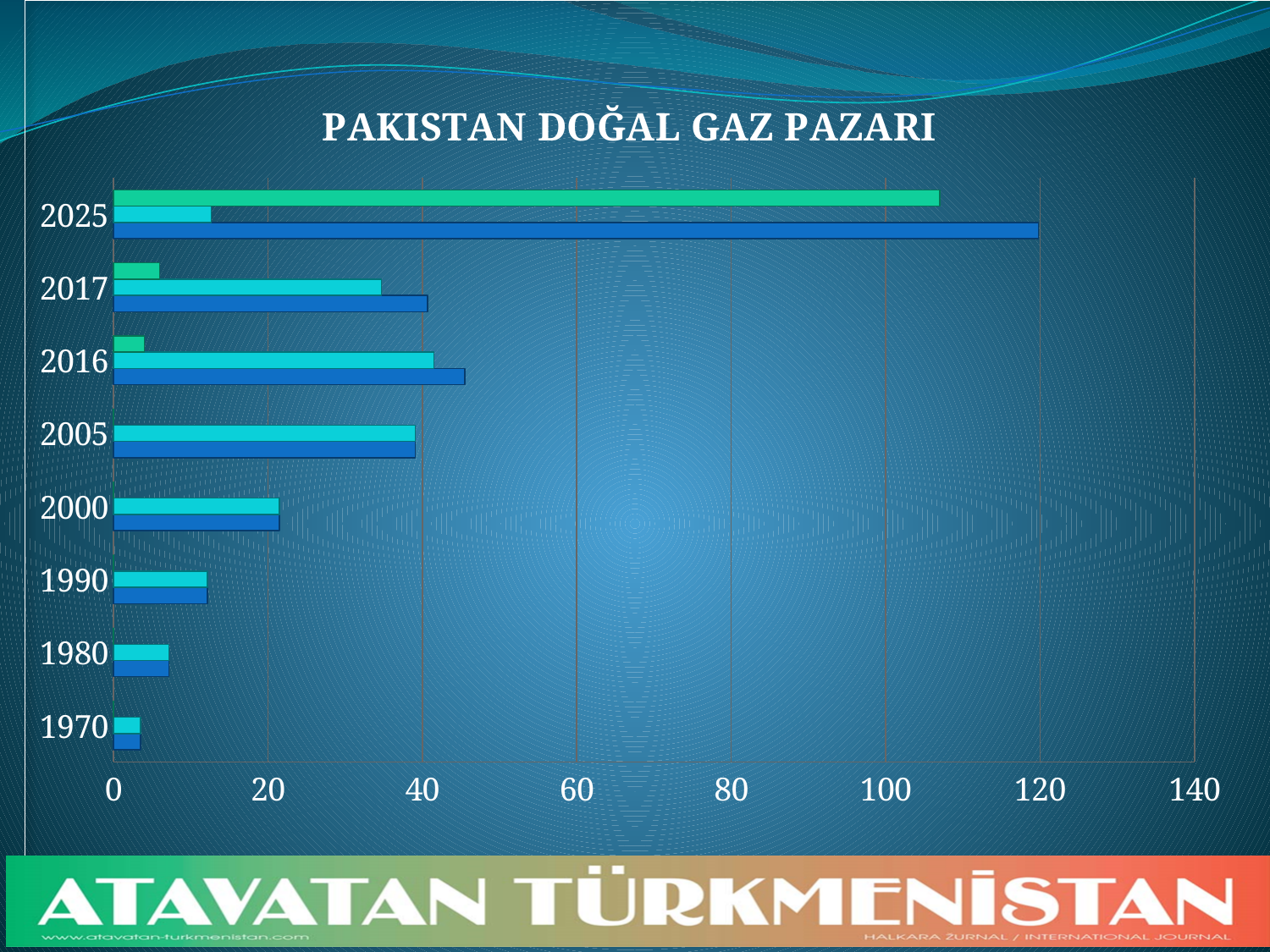
Which is larger for 2025: the green bar or the cyan bar? the green bar How many years are listed on the vertical axis of the chart? 8 Which year has the longest bar in the chart? 2025 Is the value of the green bar for 2025 greater or less than 100? greater What is the title of the chart? PAKISTAN DOĞAL GAZ PAZARI Which year has the shortest bars in the chart? 1970 Is the value of the dark blue bar for 2000 greater or less than 40? less Is the value of the dark blue bar for 1990 greater or less than 20? less Do the dark blue bars rise or fall from 1970 to 2005? rise Which is larger: the dark blue bar for 2016 or the dark blue bar for 2017? 2016 What kind of chart is shown on the slide? bar chart